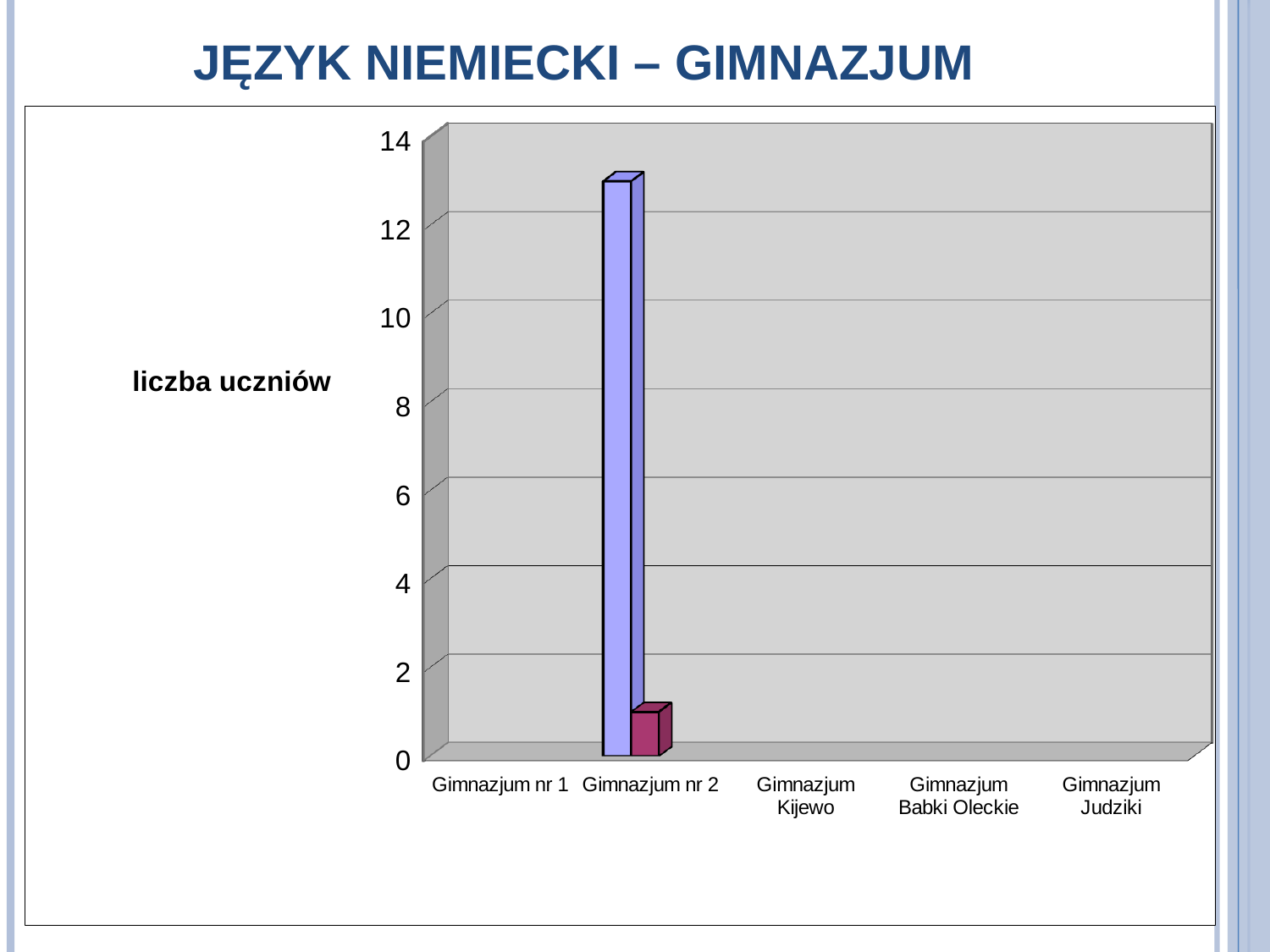
For Gimnazjum nr 2, which bar is taller, the blue one or the red one? the blue one Is the value of the red bar for Gimnazjum nr 2 greater or less than 2? less How many categories are shown on the x axis of the chart? 5 Is the value of the blue bar for Gimnazjum nr 2 greater or less than 14? less What kind of chart is shown on the slide? bar chart Which category has the tallest bar in the chart? Gimnazjum nr 2 What is the label on the vertical axis of the chart? liczba uczniów What is the highest value shown on the vertical axis of the chart? 14 Is the value of the blue bar for Gimnazjum nr 2 greater or less than 12? greater What is the title of the slide containing the chart? JĘZYK NIEMIECKI – GIMNAZJUM